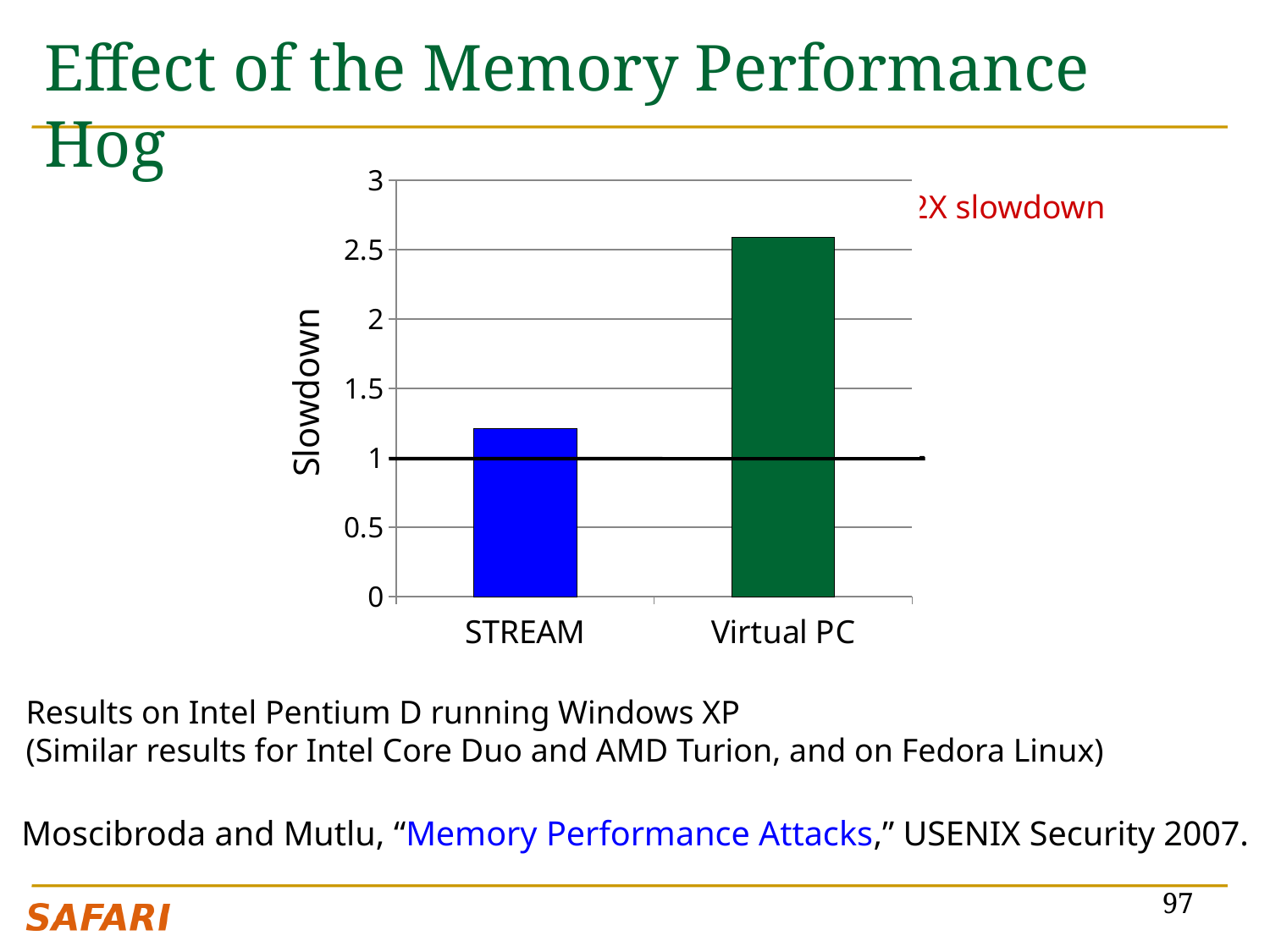
Which has the larger slowdown, STREAM or Virtual PC? Virtual PC Is the slowdown for Virtual PC greater or less than 2? greater What is the label of the y axis of the chart? Slowdown Which category has the highest slowdown in the chart? Virtual PC Is the slowdown for STREAM greater or less than 1.5? less Which category has the lowest slowdown in the chart? STREAM Do the bar values rise or fall going from STREAM to Virtual PC along the x axis? rise Is the slowdown for Virtual PC greater or less than 3? less What colour is the bar for Virtual PC? green How many categories are plotted on the x axis of the chart? 2 What kind of chart is shown on the slide? bar chart